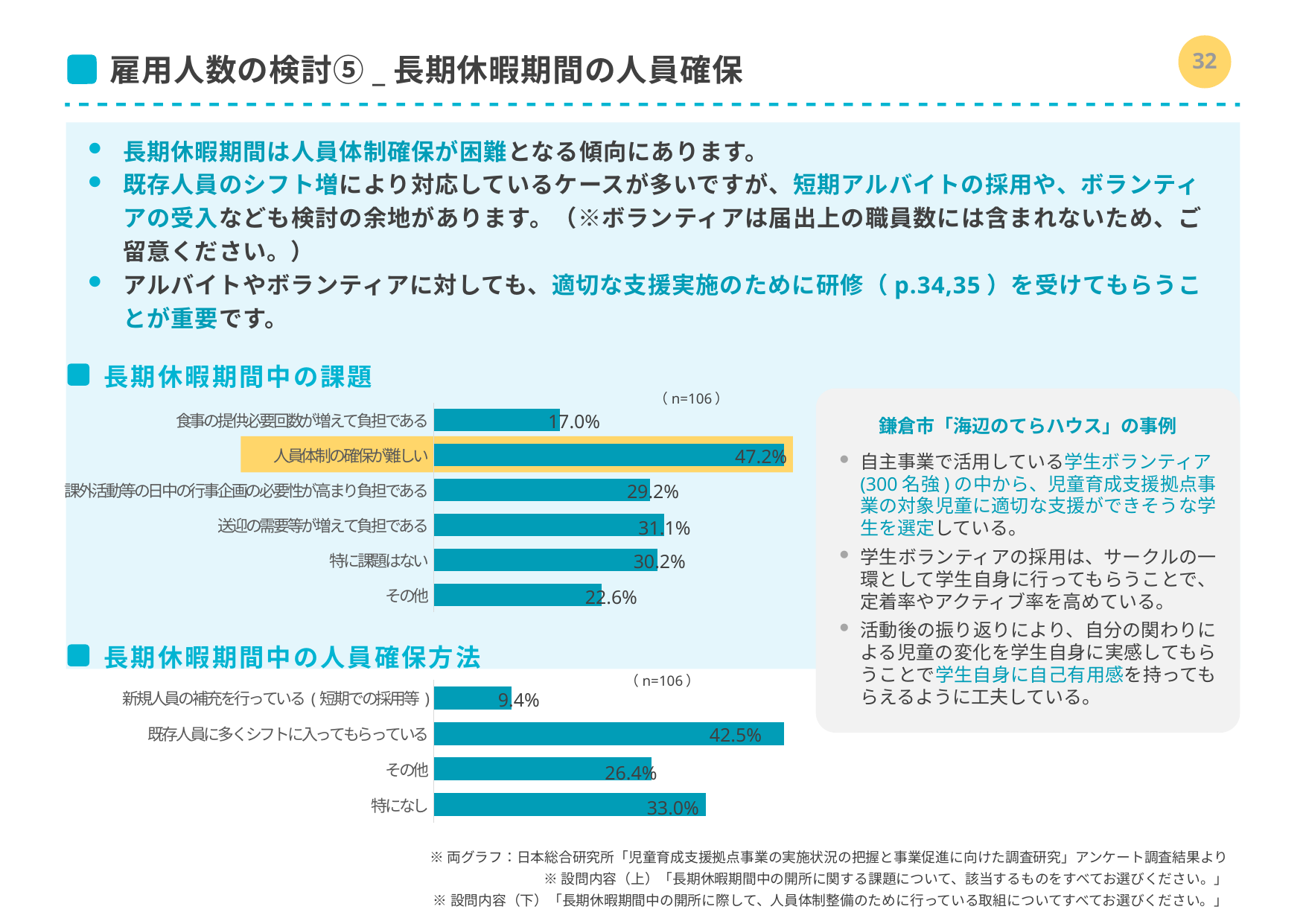
What kind of chart is the 長期休暇期間中の課題 chart? Bar chart In the 長期休暇期間中の人員確保方法 chart, what is the value for 新規人員の補充を行っている(短期での採用等)? 9.4% In the 長期休暇期間中の人員確保方法 chart, which category has the lowest value? 新規人員の補充を行っている(短期での採用等) In the 長期休暇期間中の課題 chart, what is the value for 食事の提供必要回数が増えて負担である? 17.0% In the 長期休暇期間中の課題 chart, how many categories are shown? 6 In the 長期休暇期間中の課題 chart, which category has the highest value? 人員体制の確保が難しい In the 長期休暇期間中の課題 chart, what is the difference between 人員体制の確保が難しい and その他? 24.6% In the 長期休暇期間中の人員確保方法 chart, what is the value for 既存人員に多くシフトに入ってもらっている? 42.5% In the 長期休暇期間中の人員確保方法 chart, how many categories are shown? 4 In the 長期休暇期間中の課題 chart, what is the value for 人員体制の確保が難しい? 47.2% In the 長期休暇期間中の課題 chart, which category has the lowest value? 食事の提供必要回数が増えて負担である In the 長期休暇期間中の人員確保方法 chart, which is larger: 特になし or その他? 特になし